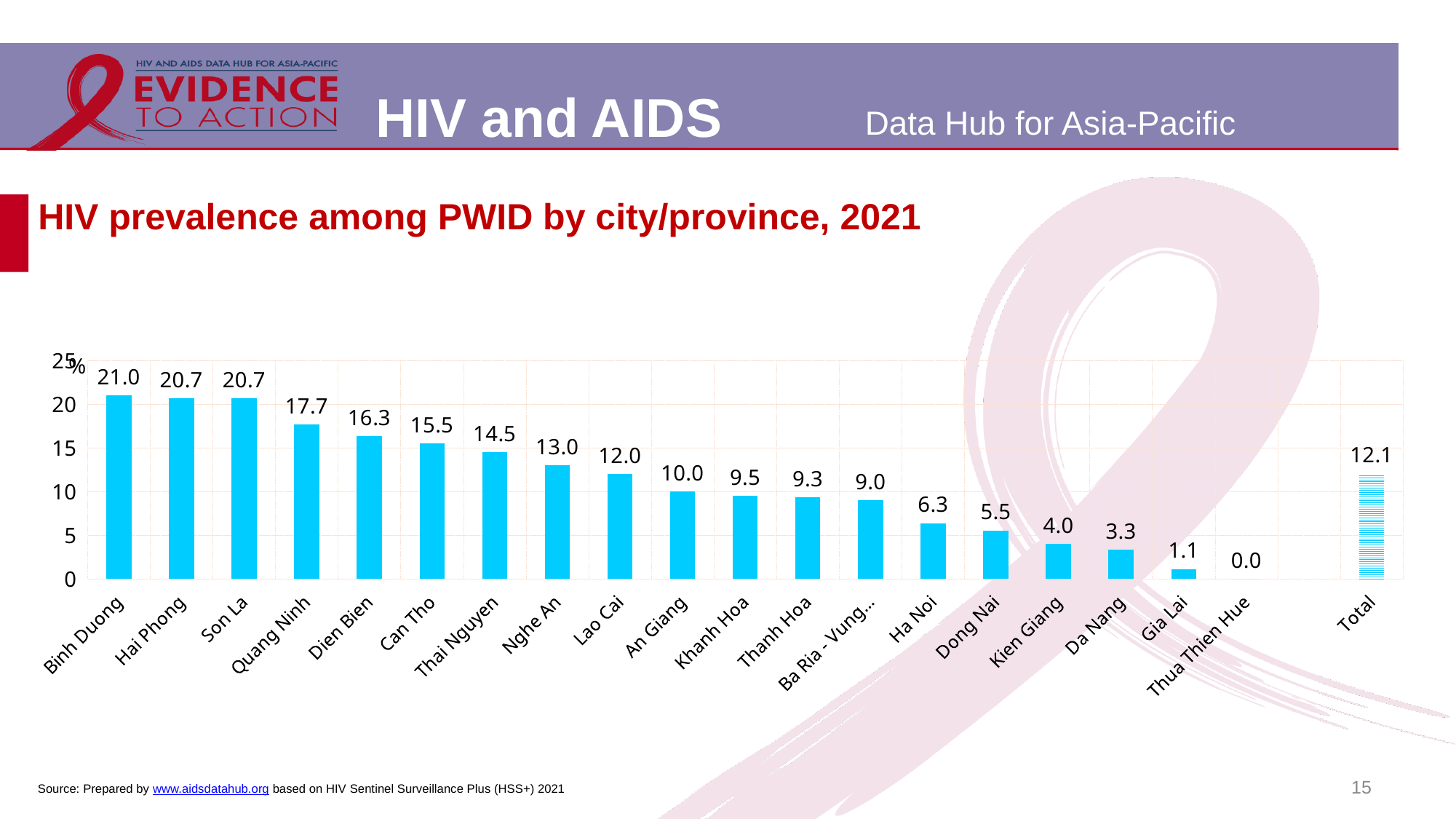
What is the value shown for Total? 12.1 What is the difference between the values for Binh Duong and Ha Noi? 14.7 What type of chart is shown on the slide? Bar chart How many cities/provinces are shown on the chart, excluding the Total bar? 19 What is the title of the chart? HIV prevalence among PWID by city/province, 2021 What is the HIV prevalence among PWID in Can Tho? 15.5 Which city/province has the highest HIV prevalence among PWID? Binh Duong What is the HIV prevalence among PWID in Ha Noi? 6.3 Is the value for Nghe An greater or less than 10? greater Do the city/province values rise or fall from left to right along the x axis? Fall Which has a higher HIV prevalence among PWID, Quang Ninh or Dien Bien? Quang Ninh Which city/province has the lowest HIV prevalence among PWID? Thua Thien Hue